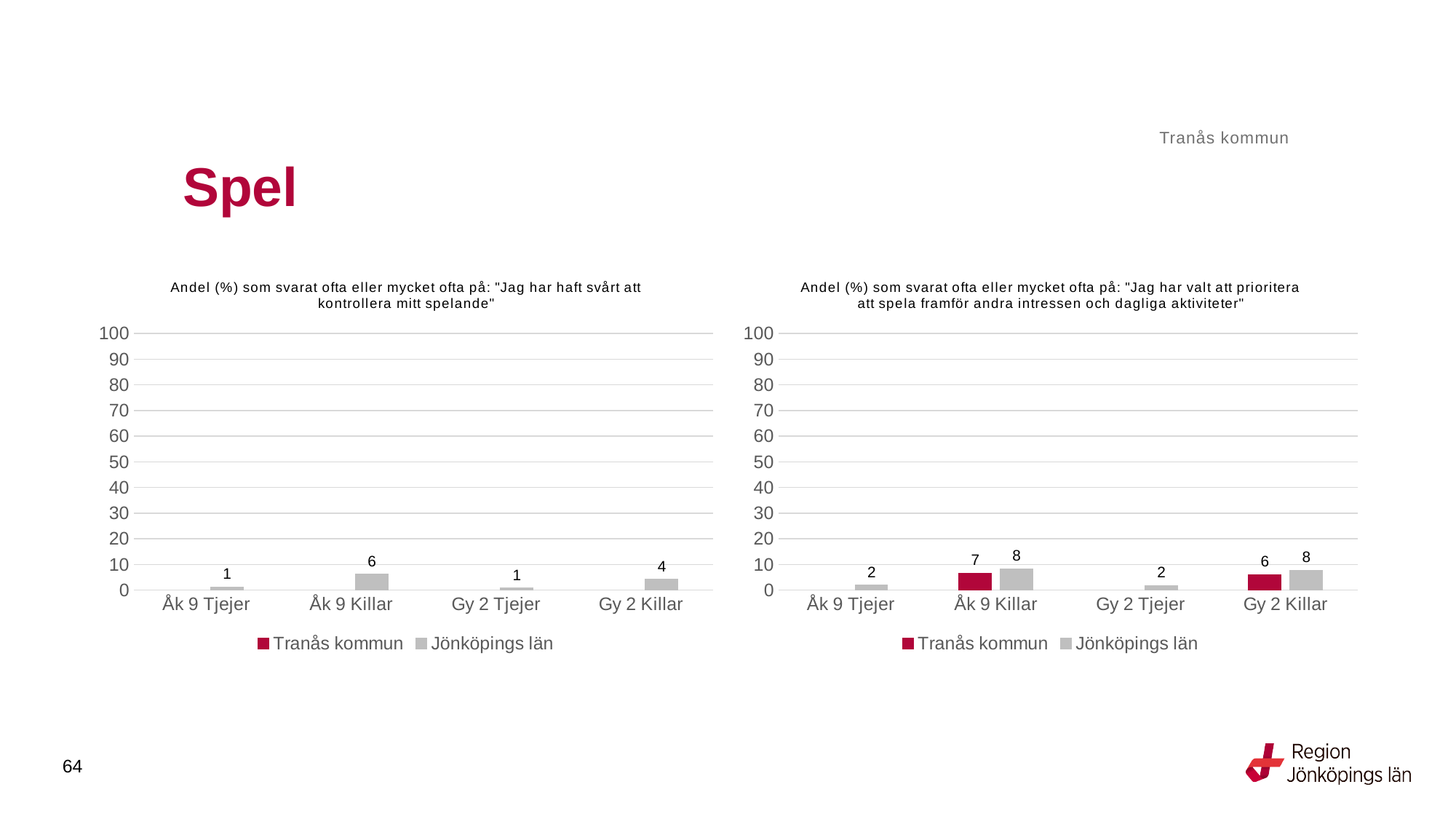
How many categories are shown on the x axis of the left chart? 4 In the right chart, what is the value for Jönköpings län for Gy 2 Tjejer? 2 In the right chart, what is the difference between Jönköpings län and Tranås kommun for Gy 2 Killar? 2 In the right chart, what is the value for Tranås kommun for Åk 9 Killar? 7 In the left chart, what is the value for Jönköpings län for Gy 2 Killar? 4 In the left chart, what is the value for Jönköpings län for Åk 9 Killar? 6 What kind of chart is the right chart? Bar chart In the right chart, what is the value for Tranås kommun for Gy 2 Killar? 6 In the left chart, what is the difference between the Jönköpings län values for Åk 9 Killar and Gy 2 Killar? 2 How many series does the legend of the right chart list? 2 In the left chart, which category has the highest Jönköpings län value? Åk 9 Killar In the right chart, which is larger for Gy 2 Killar: Tranås kommun or Jönköpings län? Jönköpings län